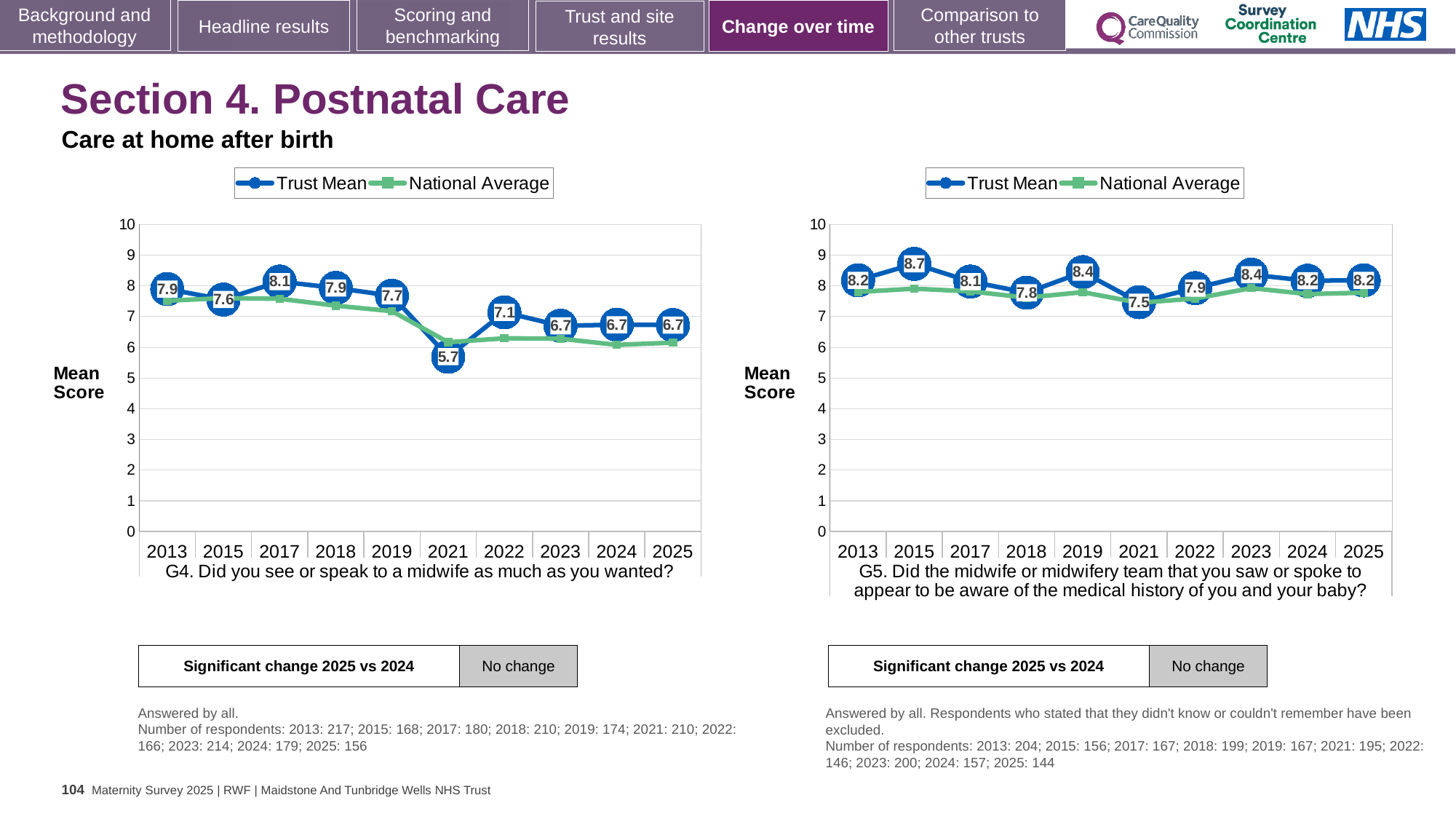
In the G4 chart, which year has the highest Trust Mean? 2017 In the G5 chart, what is the difference between the Trust Mean in 2015 and in 2021? 1.2 In the G4 chart, which year has the lowest Trust Mean? 2021 In the G5 chart, what is the Trust Mean for 2015? 8.7 In the G4 chart, is the National Average for 2013 greater or less than 7? greater In the G4 chart, what is the difference between the Trust Mean in 2017 and in 2021? 2.4 In the G5 chart, which year has the lowest Trust Mean? 2021 How many years are plotted on the x axis of the G5 chart? 10 In the G5 chart, which is larger, the Trust Mean for 2019 or for 2018? 2019 In the G4 chart, what is the Trust Mean for 2025? 6.7 In the G4 chart, what is the Trust Mean for 2021? 5.7 How many series does the legend of the G4 chart list? 2